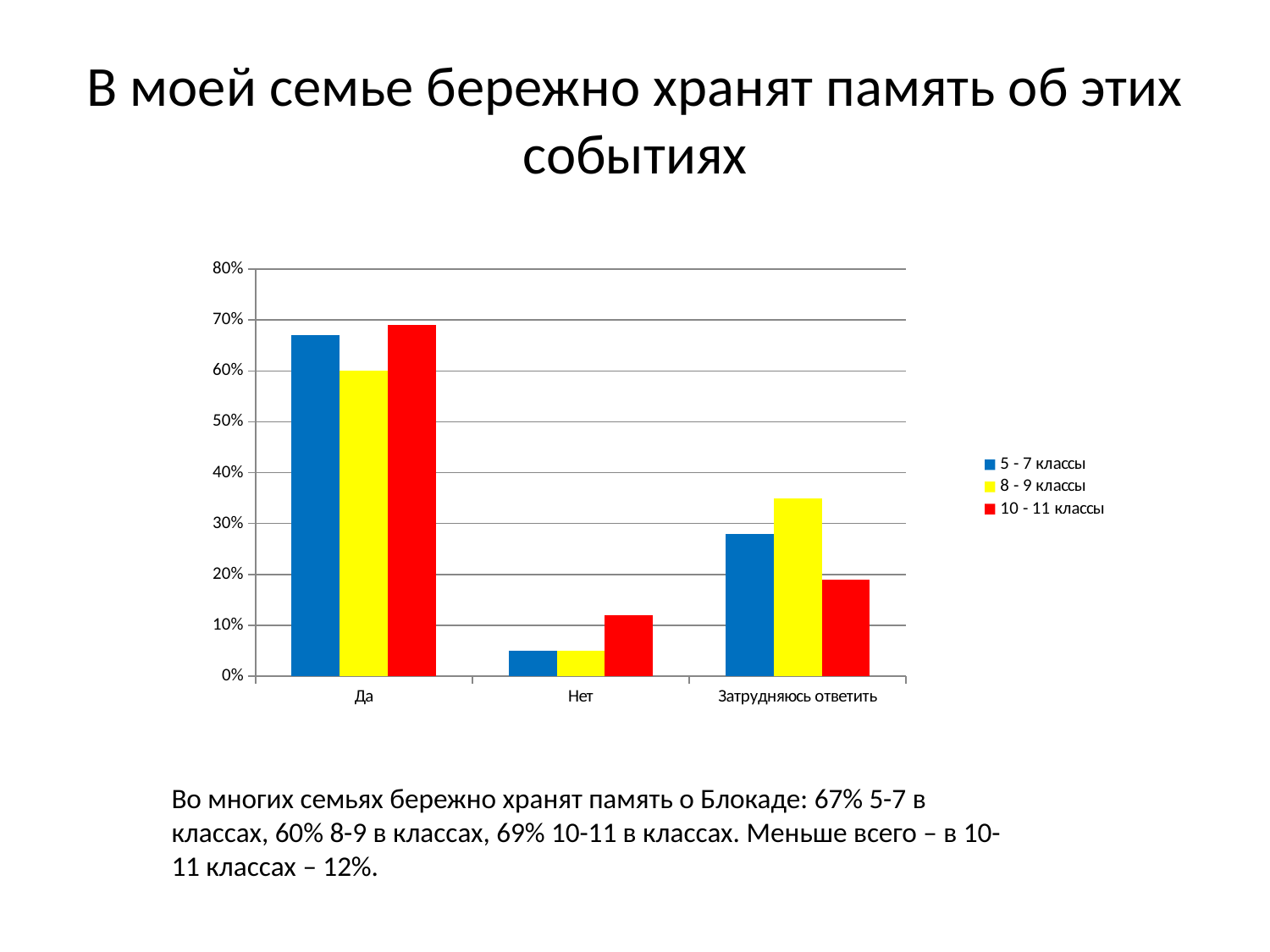
What is the value for 10 - 11 классы in the category Да? 69% Is the value for 8 - 9 классы in the category Затрудняюсь ответить greater or less than 30%? greater What is the value for 8 - 9 классы in the category Да? 60% What is the value for 5 - 7 классы in the category Да? 67% What is the difference between the values for 5 - 7 классы and 8 - 9 классы in the category Да? 7% How many categories are shown on the x axis? 3 Which is larger in the category Нет: the value for 10 - 11 классы or the value for 5 - 7 классы? 10 - 11 классы What is the value for 10 - 11 классы in the category Нет? 12% What kind of chart is shown on the slide? bar chart How many series does the legend list? 3 Which series has the lowest value in the category Да? 8 - 9 классы Which series has the highest value in the category Затрудняюсь ответить? 8 - 9 классы